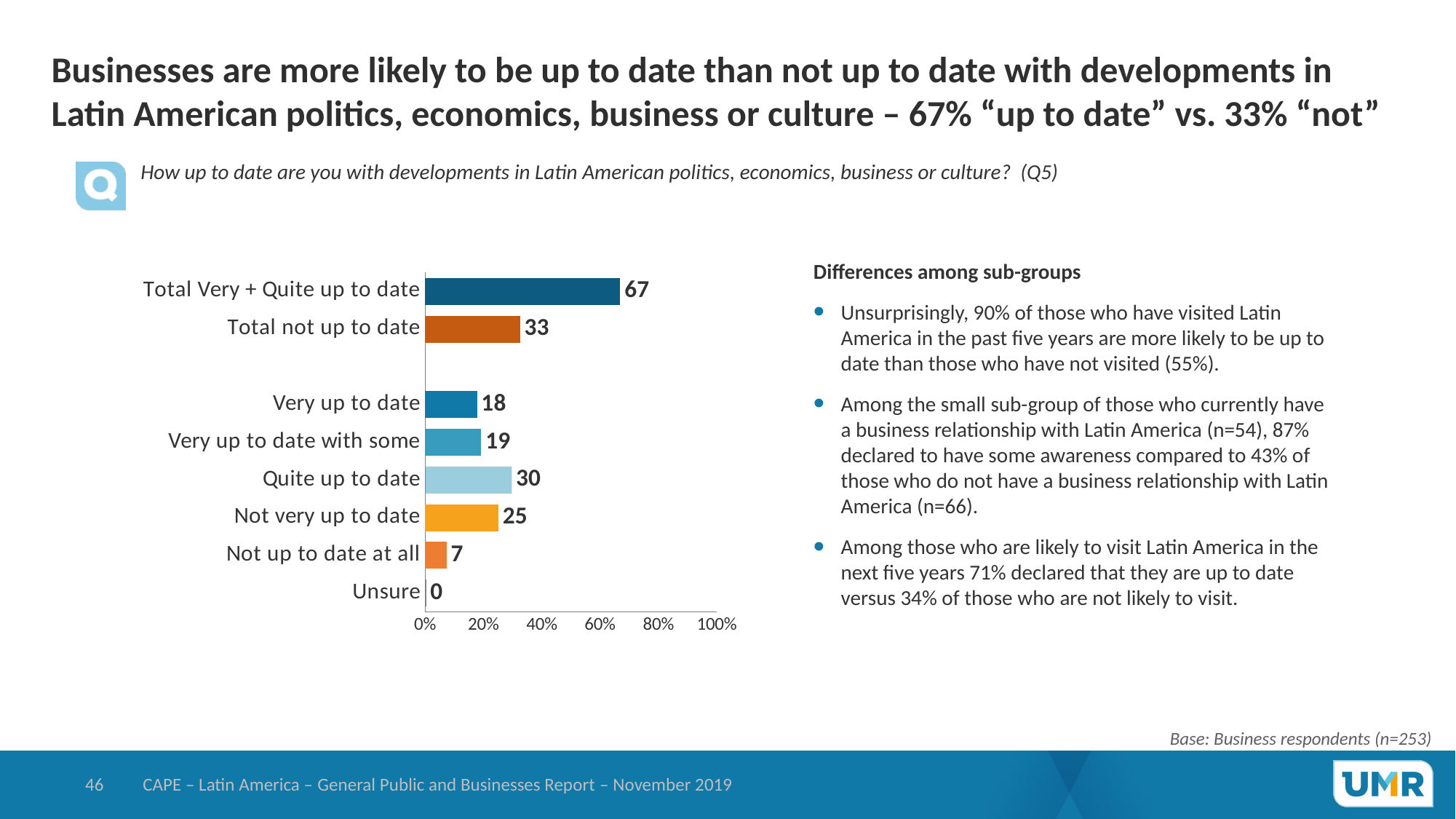
How many categories are shown in the chart? 8 What is the difference between "Total Very + Quite up to date" and "Total not up to date"? 34 Which category has the highest value? Total Very + Quite up to date Which category has the lowest value? Unsure What is the value for "Quite up to date"? 30 What kind of chart is shown on the slide? Bar chart Is the value for "Total Very + Quite up to date" greater or less than 60%? greater What is the value for "Total not up to date"? 33 What is the value for "Unsure"? 0 What is the value for "Not up to date at all"? 7 What is the value for "Total Very + Quite up to date"? 67 Which is larger, "Quite up to date" or "Not very up to date"? Quite up to date